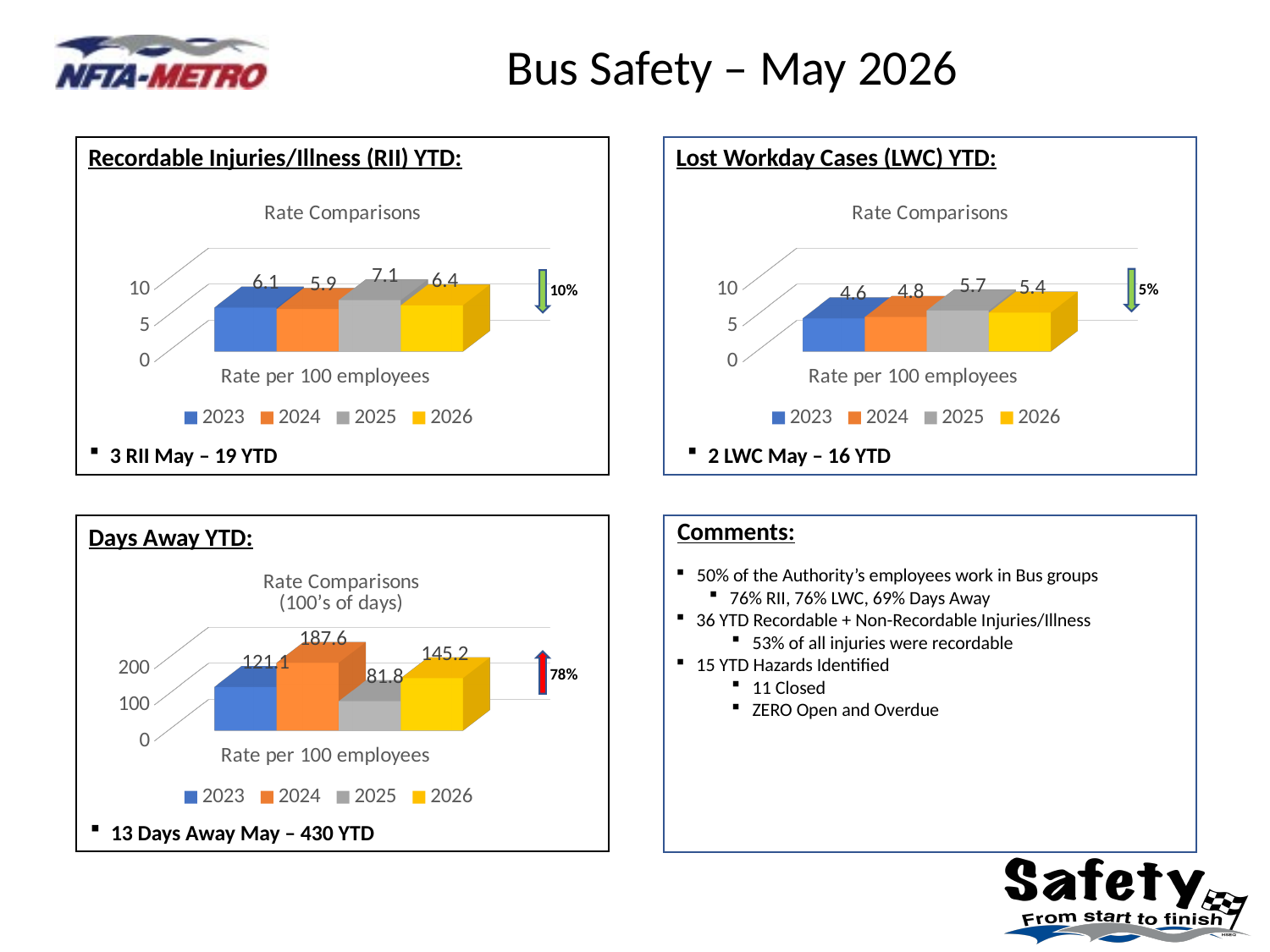
In the Days Away YTD chart, which is larger, the 2023 value or the 2026 value? 2026 In the Lost Workday Cases (LWC) YTD chart, what is the rate per 100 employees for 2023? 4.6 What type of chart is used in the Lost Workday Cases (LWC) YTD box? Bar chart In the Recordable Injuries/Illness (RII) YTD chart, what is the rate per 100 employees for 2025? 7.1 In the Lost Workday Cases (LWC) YTD chart, which year has the highest rate? 2025 In the Days Away YTD chart, what is the value for 2024? 187.6 In the Recordable Injuries/Illness (RII) YTD chart, what is the difference between the 2025 and 2026 rates? 0.7 In the Recordable Injuries/Illness (RII) YTD chart, which year has the lowest rate? 2024 How many series does the legend of the Days Away YTD chart list? 4 In the Days Away YTD chart, what is the difference between the 2024 and 2025 values? 105.8 In the Days Away YTD chart, which year has the lowest value? 2025 In the Lost Workday Cases (LWC) YTD chart, is the 2026 rate greater or less than 5? greater